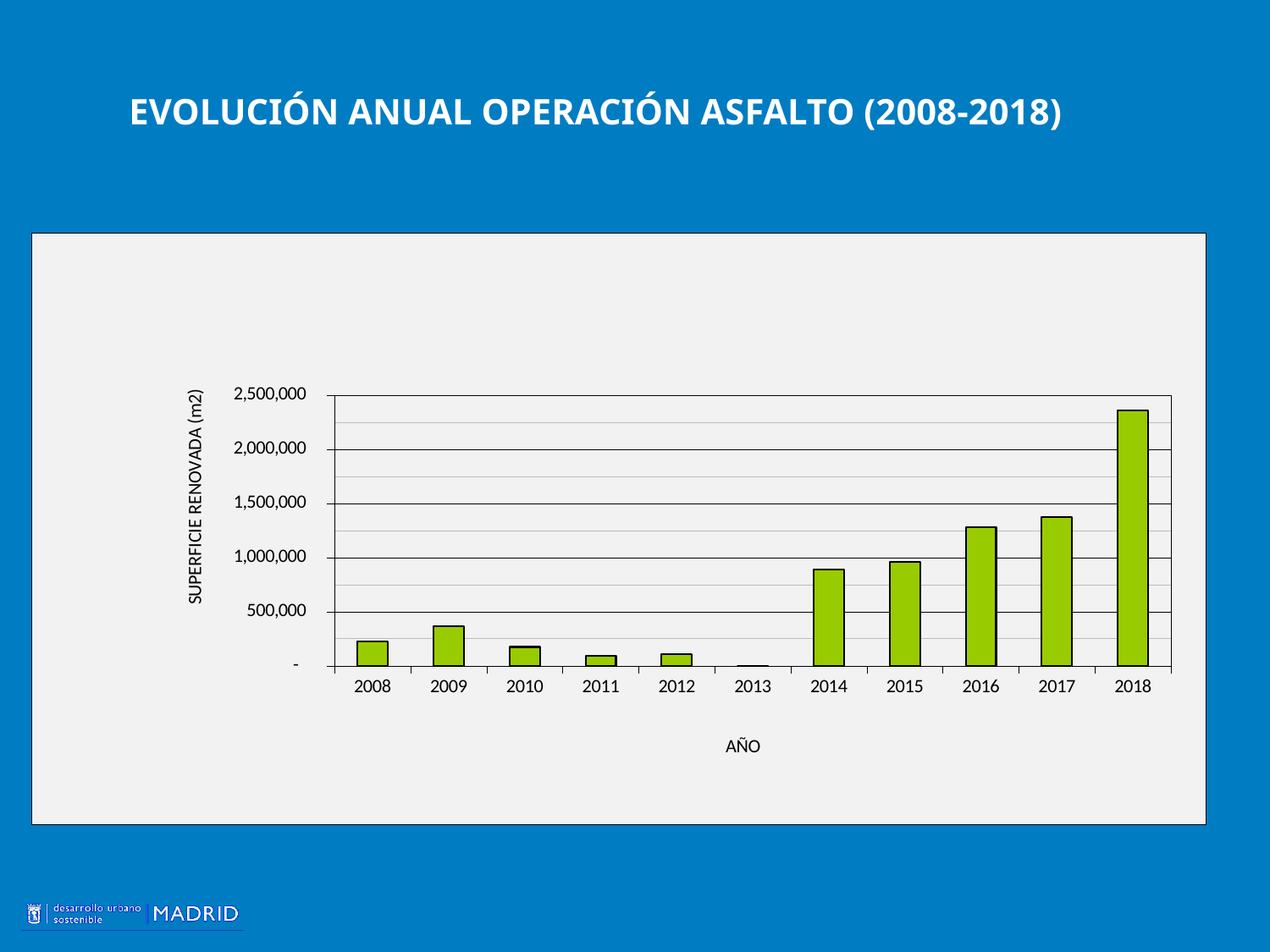
Is the value for 2016 greater or less than 1,000,000? greater How many years are plotted on the x axis of the chart? 11 Which year has the lowest value in the chart? 2013 Which year has the larger value, 2017 or 2018? 2018 Is the value for 2009 greater or less than 500,000? less Is the value for 2018 greater or less than 2,000,000? greater What is the label of the y axis of the chart? SUPERFICIE RENOVADA (m2) Do the values rise or fall from 2014 to 2018? rise Which year has the larger value, 2008 or 2009? 2009 Which year has the highest value in the chart? 2018 What kind of chart is shown on the slide? bar chart